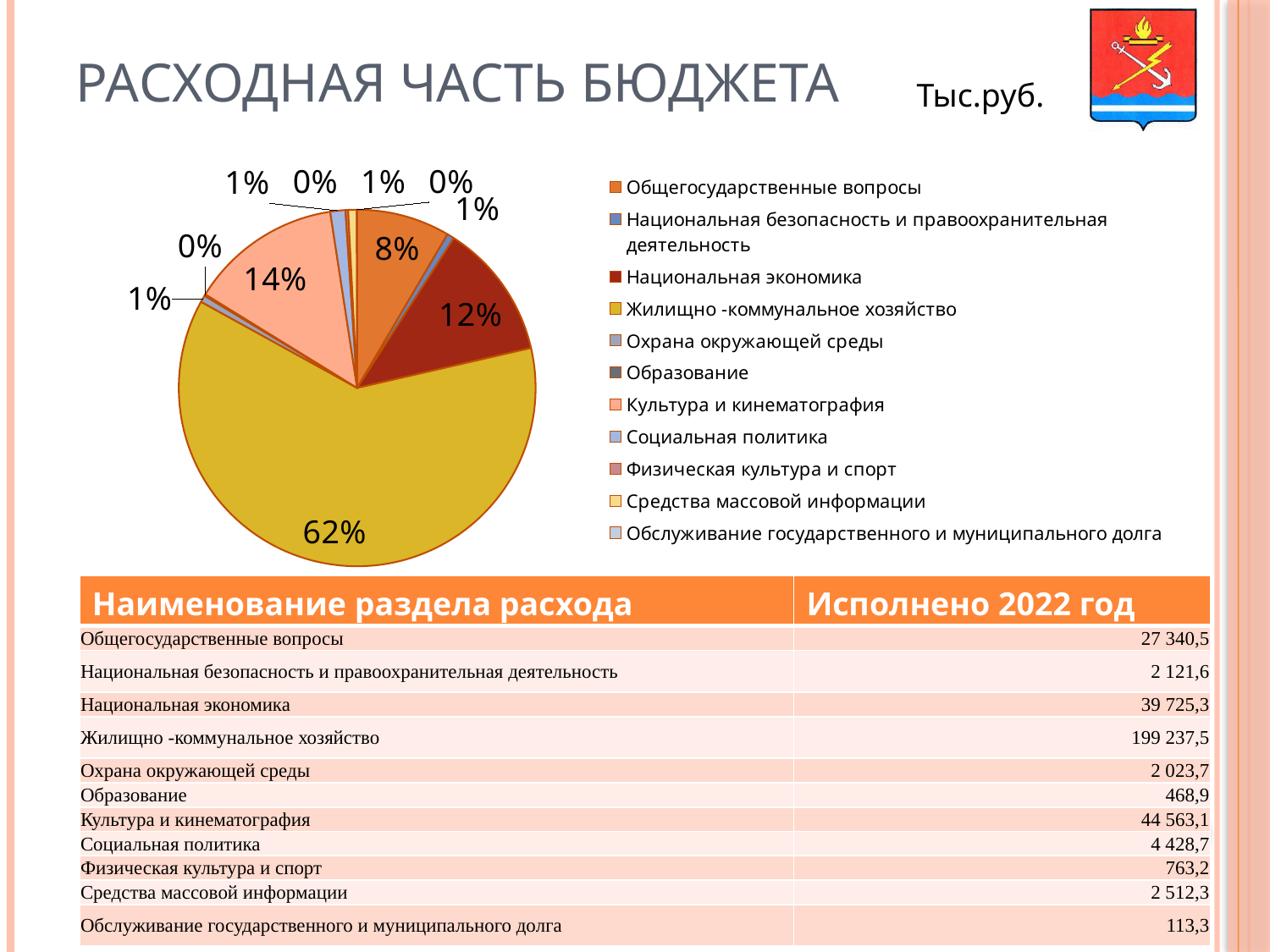
What is the title of the slide's chart? РАСХОДНАЯ ЧАСТЬ БЮДЖЕТА Which category has the largest share of the pie chart? Жилищно -коммунальное хозяйство Which has the larger share in the pie chart, Общегосударственные вопросы or Национальная экономика? Национальная экономика Which has the larger share in the pie chart, Национальная экономика or Культура и кинематография? Культура и кинематография What kind of chart is shown on the slide? pie chart What share of the pie chart does Национальная экономика have? 12% How many categories does the legend of the pie chart list? 11 What share of the pie chart does Общегосударственные вопросы have? 8% What unit is indicated next to the chart title? Тыс.руб. What share of the pie chart does Жилищно -коммунальное хозяйство have? 62% By how many percentage points does the share of Жилищно -коммунальное хозяйство exceed that of Культура и кинематография? 48